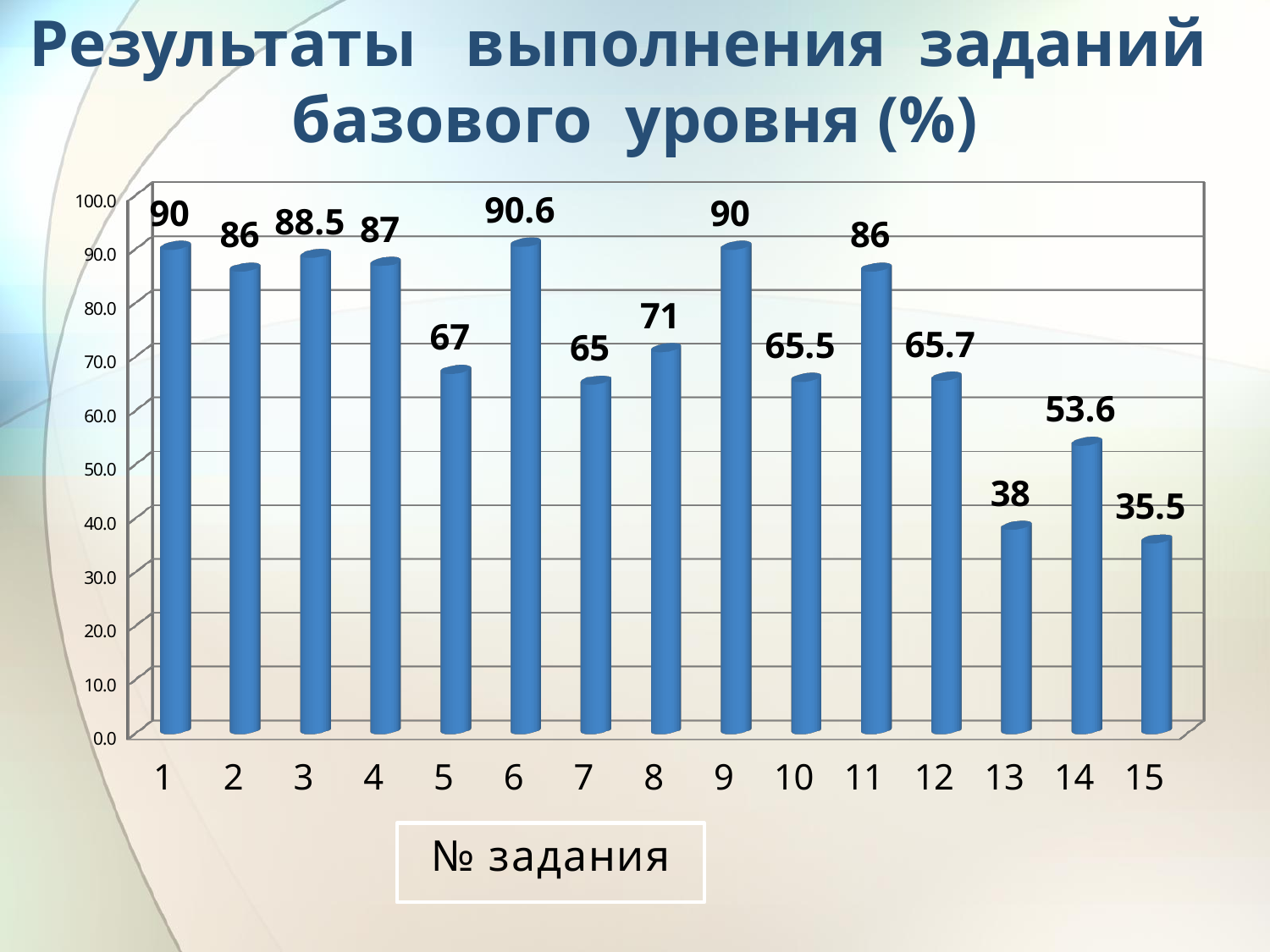
Do the values rise or fall from task 12 to task 15 overall? fall What is the difference between the values for task 1 and task 15? 54.5 Which task has the lowest value? 15 What is the value for task 10? 65.5 What is the label of the x axis? № задания What is the value for task 6? 90.6 Is the value for task 14 greater or less than 50? greater What is the value for task 13? 38 What kind of chart is shown on the slide? bar chart How many tasks are shown on the x axis? 15 Which task has the highest value? 6 Which is larger, the value for task 8 or the value for task 12? task 8